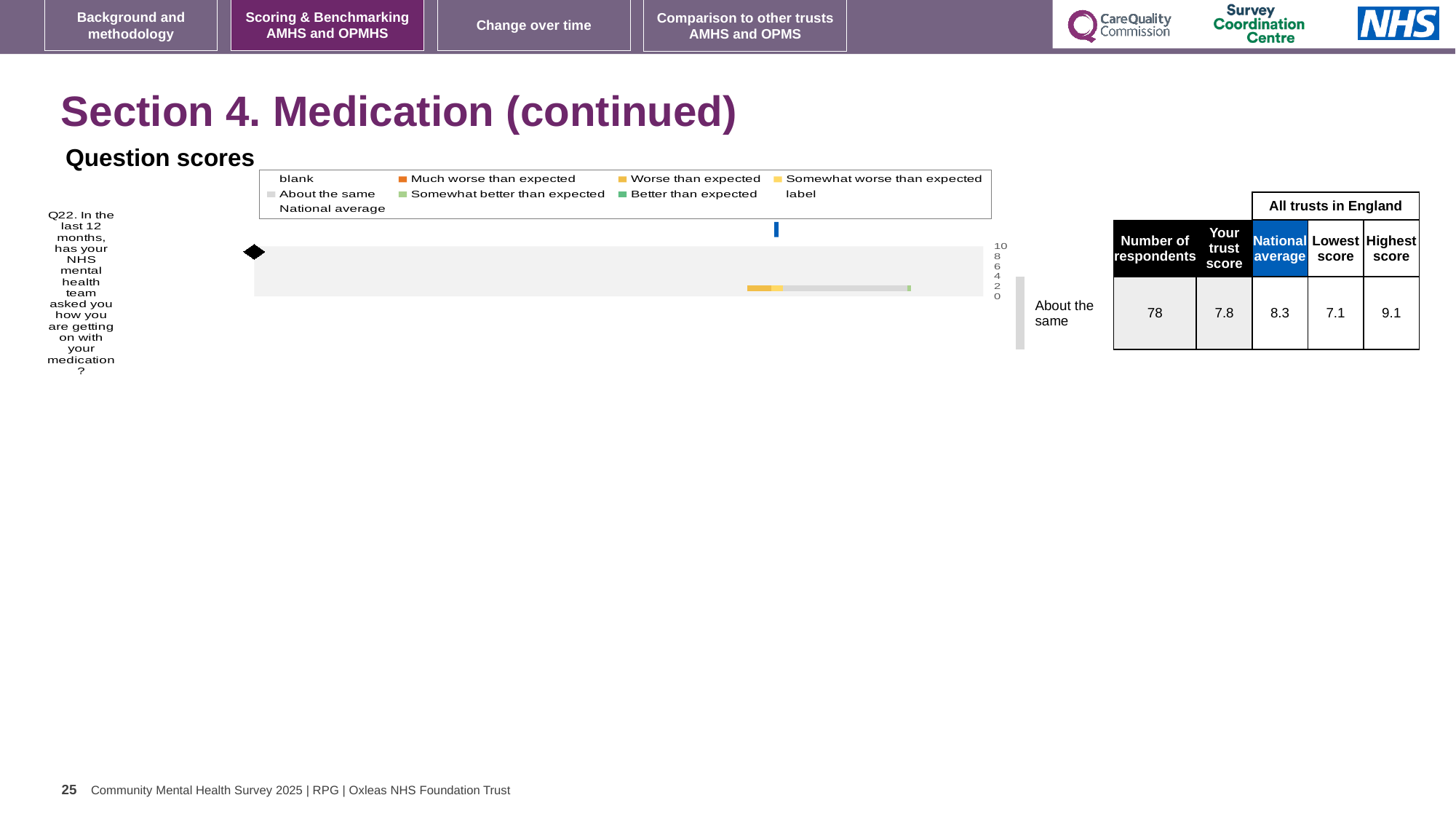
In the table beside the chart, what is the number of respondents for Q22? 78 What benchmark category label is shown beside the chart for Q22? About the same In the table beside the chart, what is the national average for Q22? 8.3 Which question number is plotted on the chart? Q22 What is the highest tick value shown on the chart's axis? 10 In the table beside the chart, what is the trust's score for Q22? 7.8 How many entries does the chart's legend list? 9 In the table beside the chart, is the trust's score for Q22 larger or smaller than the national average? smaller How many questions (categories) are plotted on the chart? 1 In the table beside the chart, what is the highest score among all trusts in England for Q22? 9.1 In the table beside the chart, what is the lowest score among all trusts in England for Q22? 7.1 What kind of chart is shown under the 'Question scores' heading? bar chart